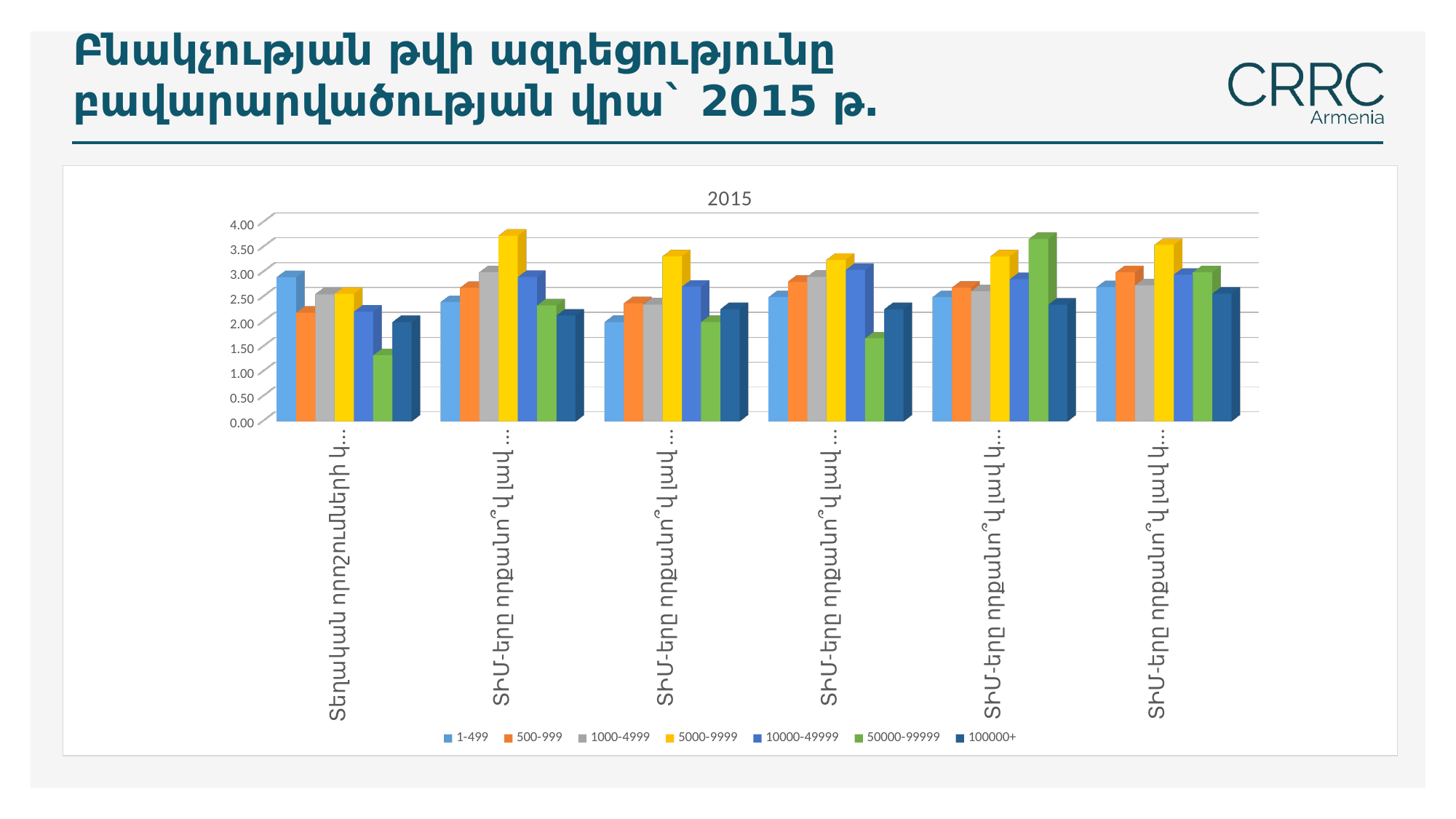
Is the value for the 50000-99999 series in the first (leftmost) category greater or less than 1.50? less In the second category from the left, which series has the highest bar? 5000-9999 Which series in the legend is shown in yellow? 5000-9999 In the fifth category from the left, which is larger: the 50000-99999 bar or the 100000+ bar? 50000-99999 How many categories are plotted along the x axis of the chart? 6 Is the value for the 5000-9999 series in the second category from the left greater or less than 3.50? greater What kind of chart is shown on the slide? bar chart In the first (leftmost) category, which series has the lowest bar? 50000-99999 In the first (leftmost) category, which series has the highest bar? 1-499 What is the title shown above the chart? 2015 How many series does the chart's legend list? 7 In the fifth category from the left, which series has the highest bar? 50000-99999